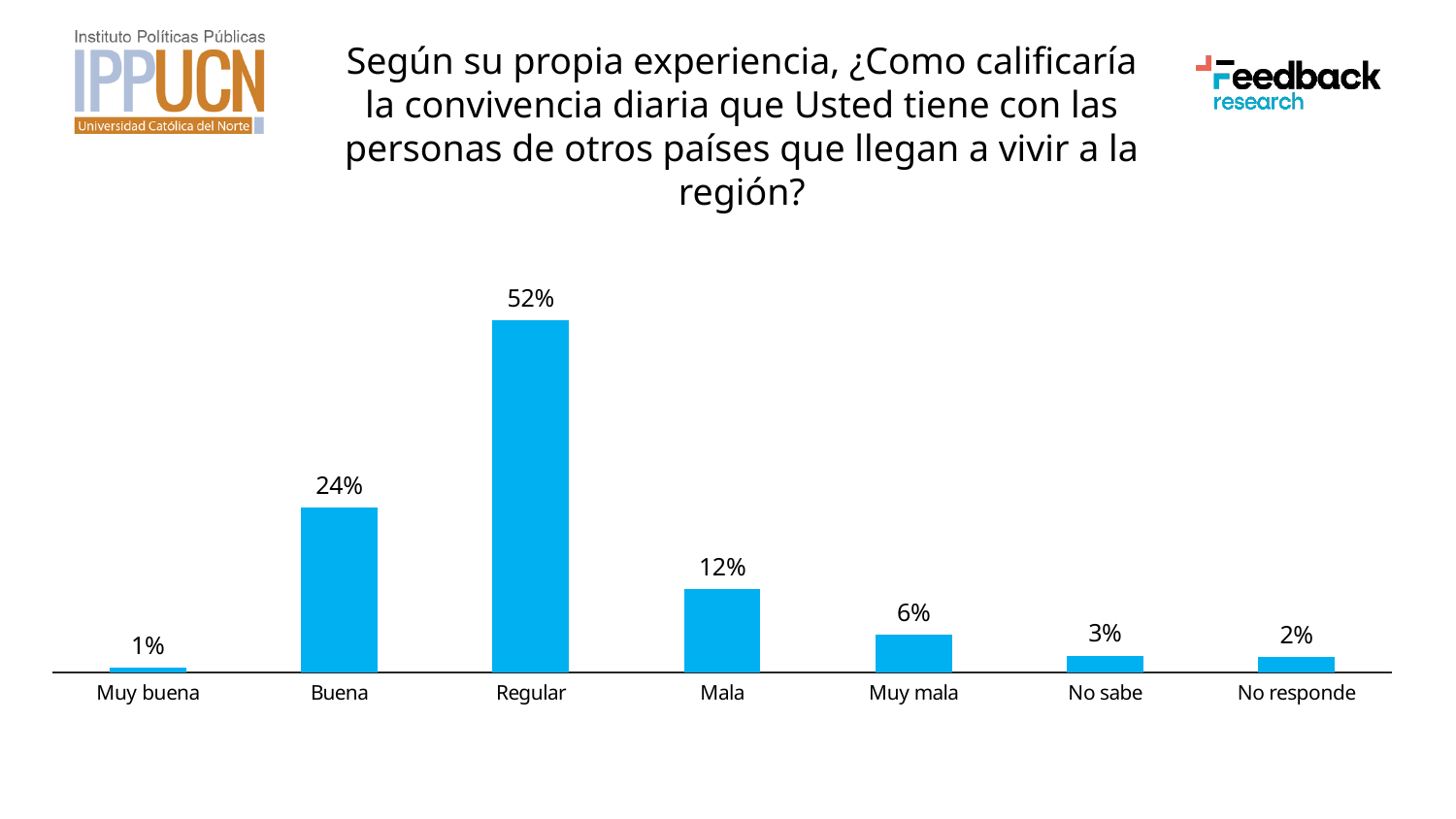
Which category has the highest value? Regular What is the value for Buena? 24% Which is larger, the value for Mala or the value for No sabe? Mala What kind of chart is shown on the slide? Bar chart How many categories are shown on the x axis? 7 What is the difference between the values for Regular and Buena? 28% What is the value for Muy mala? 6% What is the difference between the values for Mala and Muy mala? 6% What is the value for Regular? 52% Which category has the lowest value? Muy buena What is the value for No responde? 2% What colour are the bars in the chart? Light blue